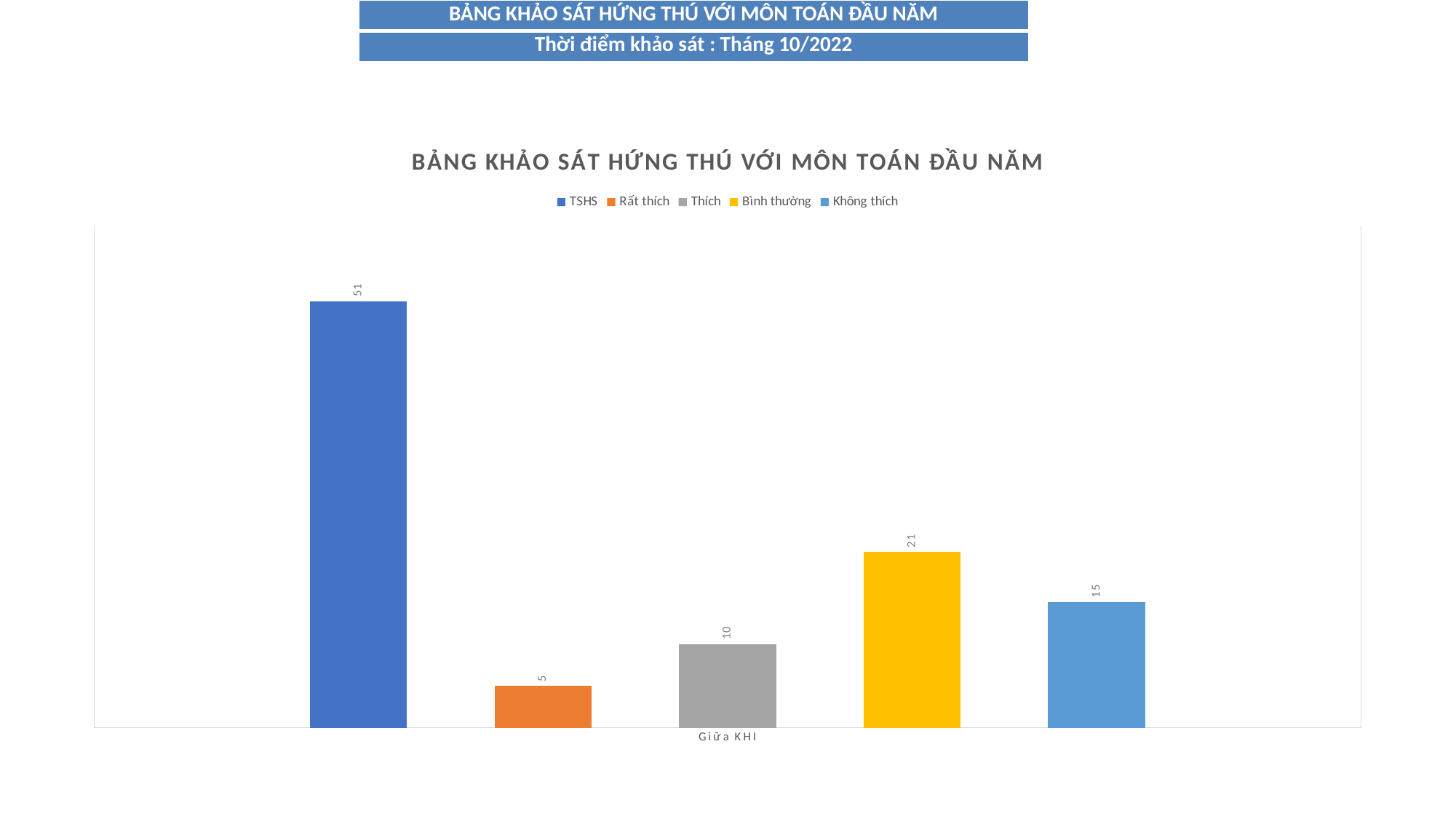
Which series has the highest value? TSHS How many series does the legend list? 5 What is the value of the Bình thường bar? 21 Which is larger, the Thích value or the Không thích value? Không thích What is the value of the Thích bar? 10 Which series has the lowest value? Rất thích What is the difference between the Bình thường and Không thích values? 6 What is the value of the TSHS bar? 51 What is the title of the chart? BẢNG KHẢO SÁT HỨNG THÚ VỚI MÔN TOÁN ĐẦU NĂM What is the value of the Rất thích bar? 5 What is the value of the Không thích bar? 15 What kind of chart is shown on the slide? bar chart